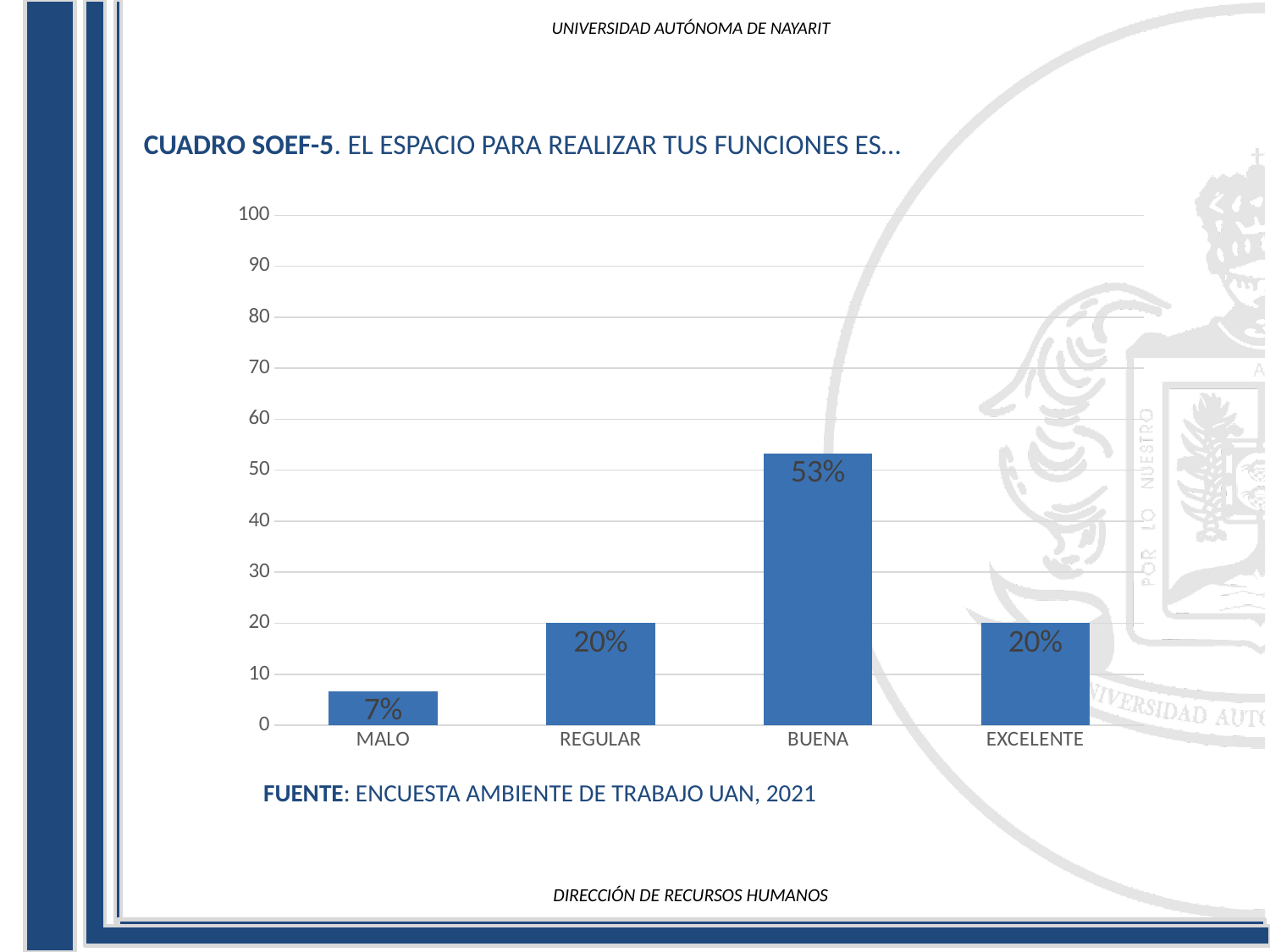
What is the difference between the values for EXCELENTE and MALO? 13% Is the value for BUENA greater or less than 50? greater Which category has the lowest value? MALO Which is larger, the value for BUENA or the value for EXCELENTE? BUENA What kind of chart is shown on the slide? bar chart What is the value for MALO? 7% How many categories are shown on the x axis? 4 What is the difference between the values for BUENA and REGULAR? 33% What is the value for REGULAR? 20% What is the source cited below the chart? ENCUESTA AMBIENTE DE TRABAJO UAN, 2021 Which category has the highest value? BUENA What is the value for BUENA? 53%